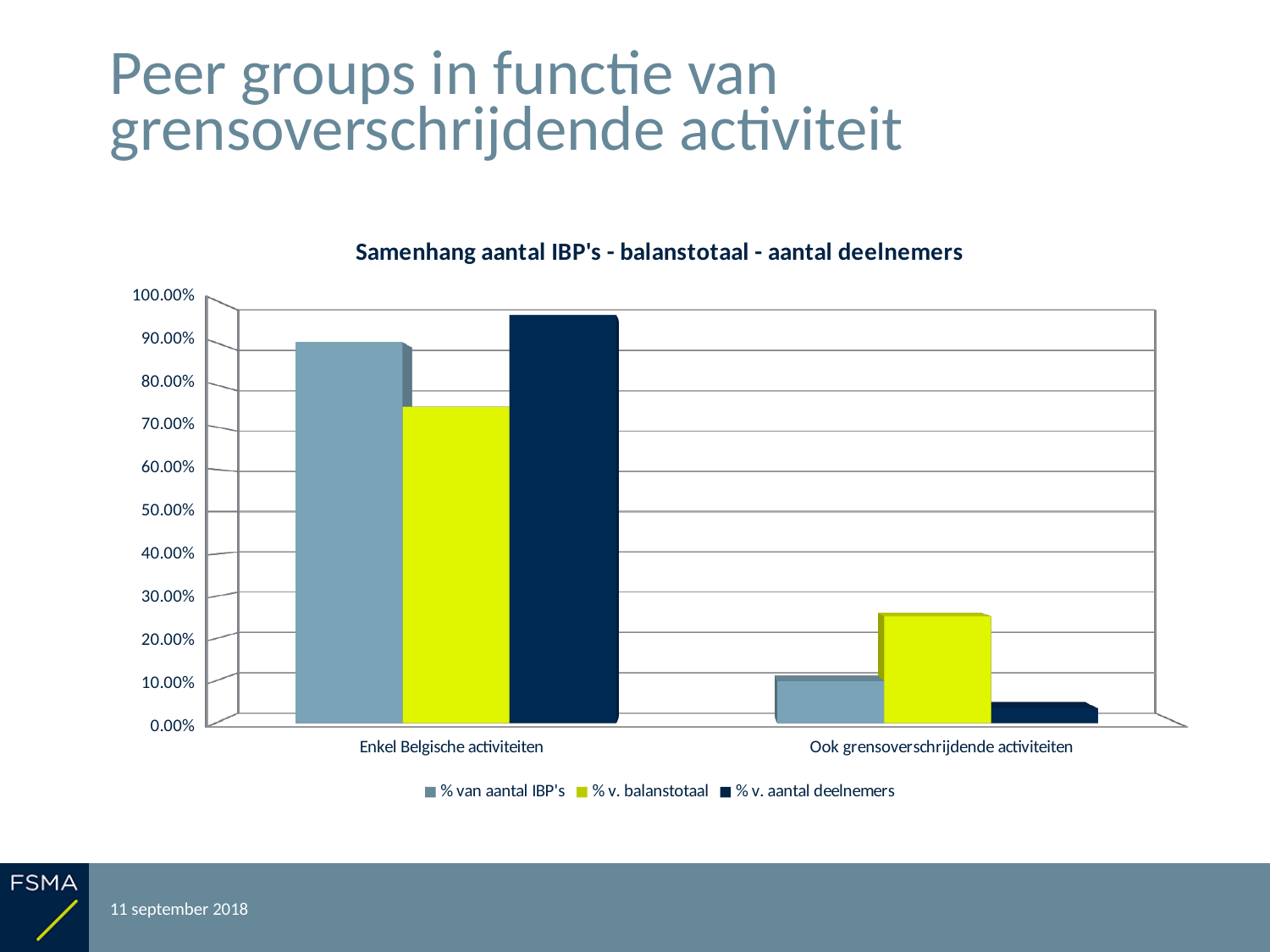
How many series does the legend list? 3 Which series has the lowest value for Enkel Belgische activiteiten? % v. balanstotaal Which series has the highest value for Ook grensoverschrijdende activiteiten? % v. balanstotaal How many categories are shown on the x axis? 2 Which is larger: % v. balanstotaal for Enkel Belgische activiteiten or % v. balanstotaal for Ook grensoverschrijdende activiteiten? Enkel Belgische activiteiten Is the value of % v. balanstotaal for Ook grensoverschrijdende activiteiten greater or less than 30.00%? less What is the title of the chart? Samenhang aantal IBP's - balanstotaal - aantal deelnemers What type of chart is shown on the slide? bar chart Which series has the lowest value for Ook grensoverschrijdende activiteiten? % v. aantal deelnemers Which series has the highest value for Enkel Belgische activiteiten? % v. aantal deelnemers Is the value of % v. aantal deelnemers for Ook grensoverschrijdende activiteiten greater or less than 10.00%? less Is the value of % van aantal IBP's for Enkel Belgische activiteiten greater or less than 80.00%? greater